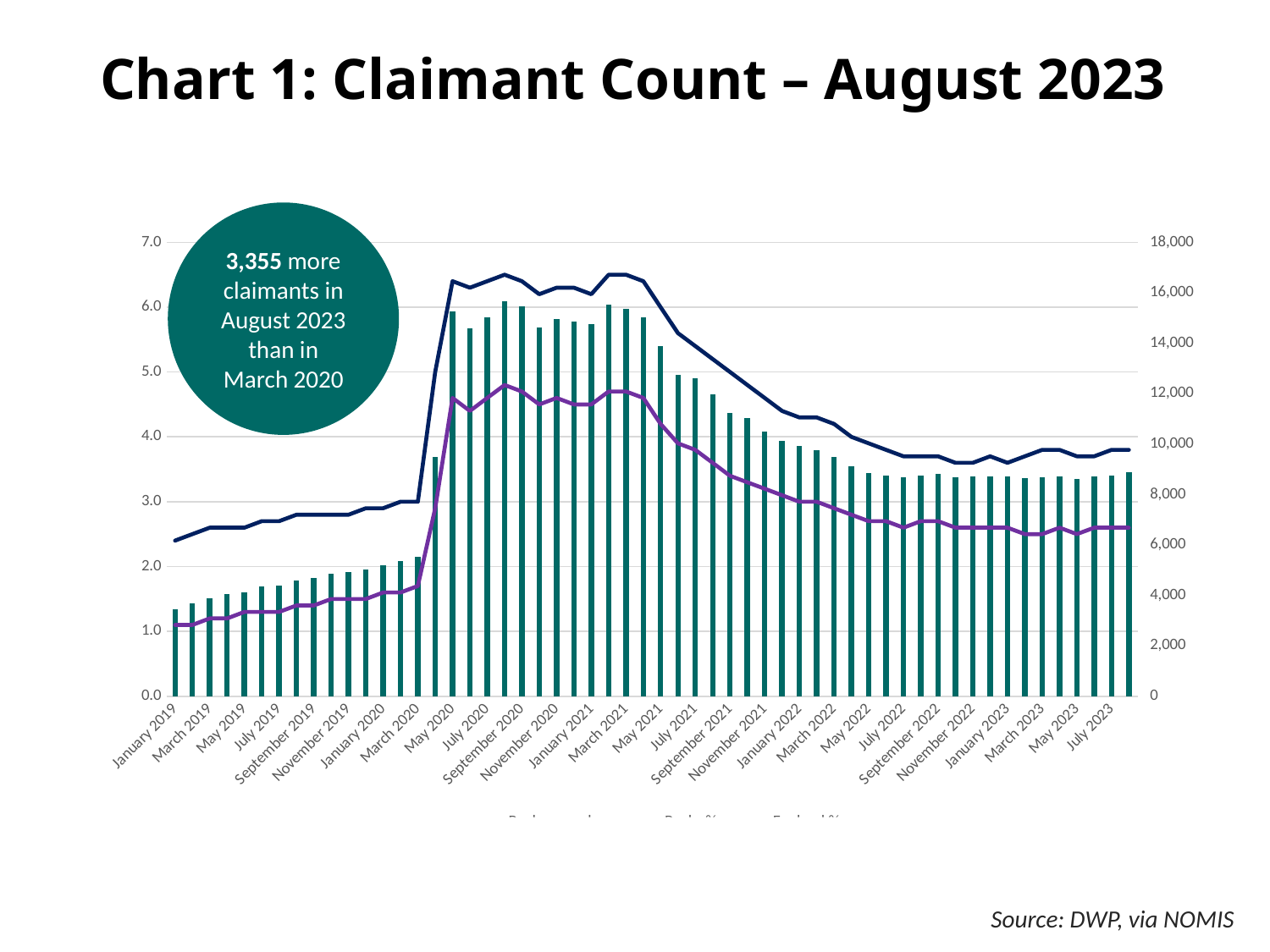
According to the callout on the chart, how many more claimants were there in August 2023 than in March 2020? 3,355 Which bar is taller, May 2020 or July 2023? May 2020 What is the source given for the chart? DWP, via NOMIS Is the value of the dark navy line in March 2021 greater or less than 6.0? greater Which month has the lowest bar on the chart? January 2019 Is the bar value for January 2019 greater or less than 4,000? less Do the bar values rise or fall between May 2021 and July 2022? fall Is the value of the purple line in January 2019 greater or less than 2.0? less What is the title of the chart on the slide? Chart 1: Claimant Count – August 2023 What kind of chart is Chart 1? A combined bar and line chart